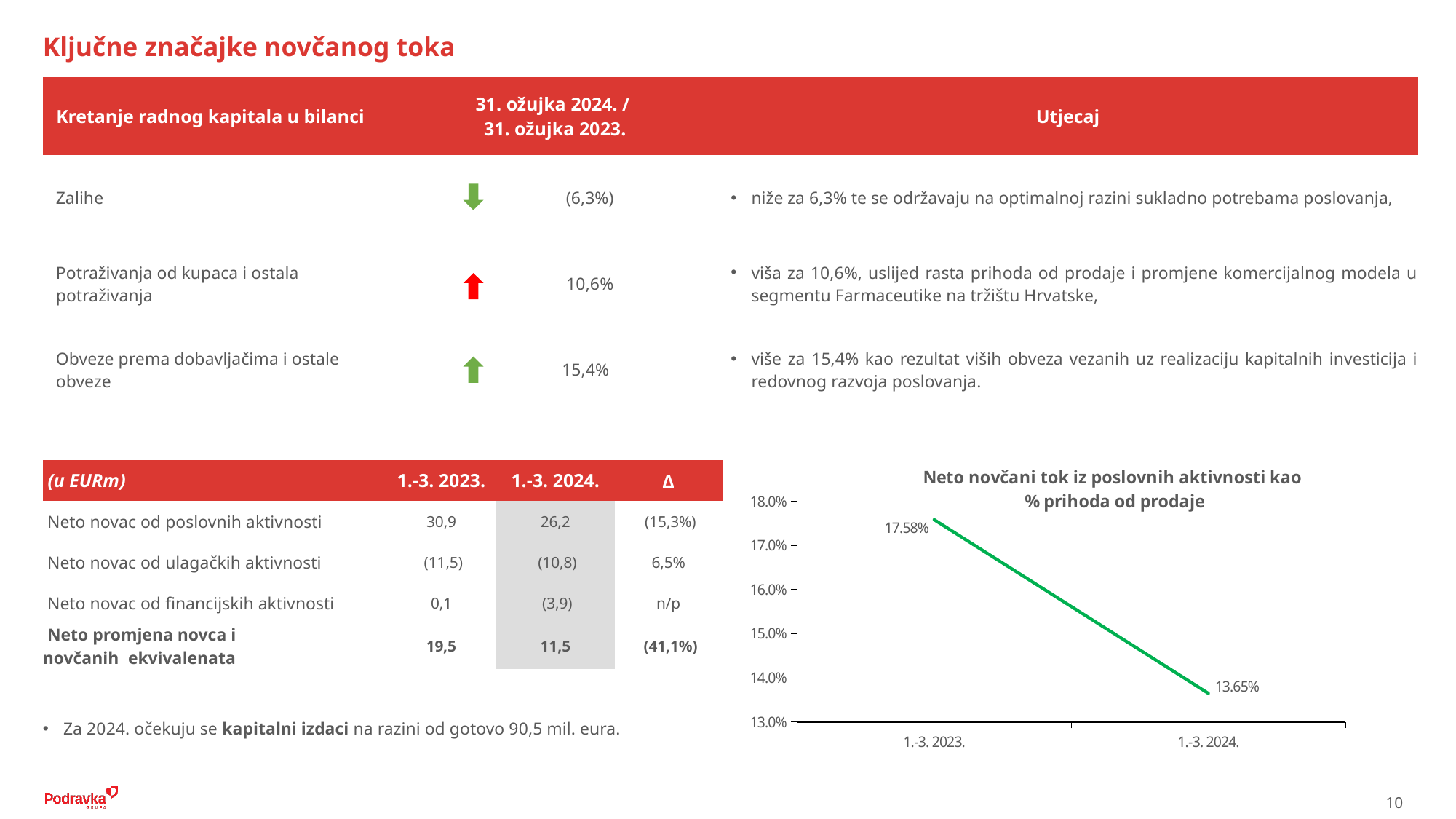
What is the value for 1.-3. 2024. in the chart? 13.65% What kind of chart is shown on the slide? Line chart Is the value for 1.-3. 2024. greater or less than 14.0%? less Which period has the highest value in the chart? 1.-3. 2023. Is the value for 1.-3. 2023. greater or less than 17.0%? greater Which is larger, the value for 1.-3. 2023. or the value for 1.-3. 2024.? 1.-3. 2023. By how many percentage points does the value for 1.-3. 2023. exceed the value for 1.-3. 2024.? 3.93 percentage points Does the value rise or fall from 1.-3. 2023. to 1.-3. 2024.? Fall What is the title of the chart? Neto novčani tok iz poslovnih aktivnosti kao % prihoda od prodaje How many data points are plotted in the chart? 2 Which period has the lowest value in the chart? 1.-3. 2024. What is the value for 1.-3. 2023. in the chart? 17.58%